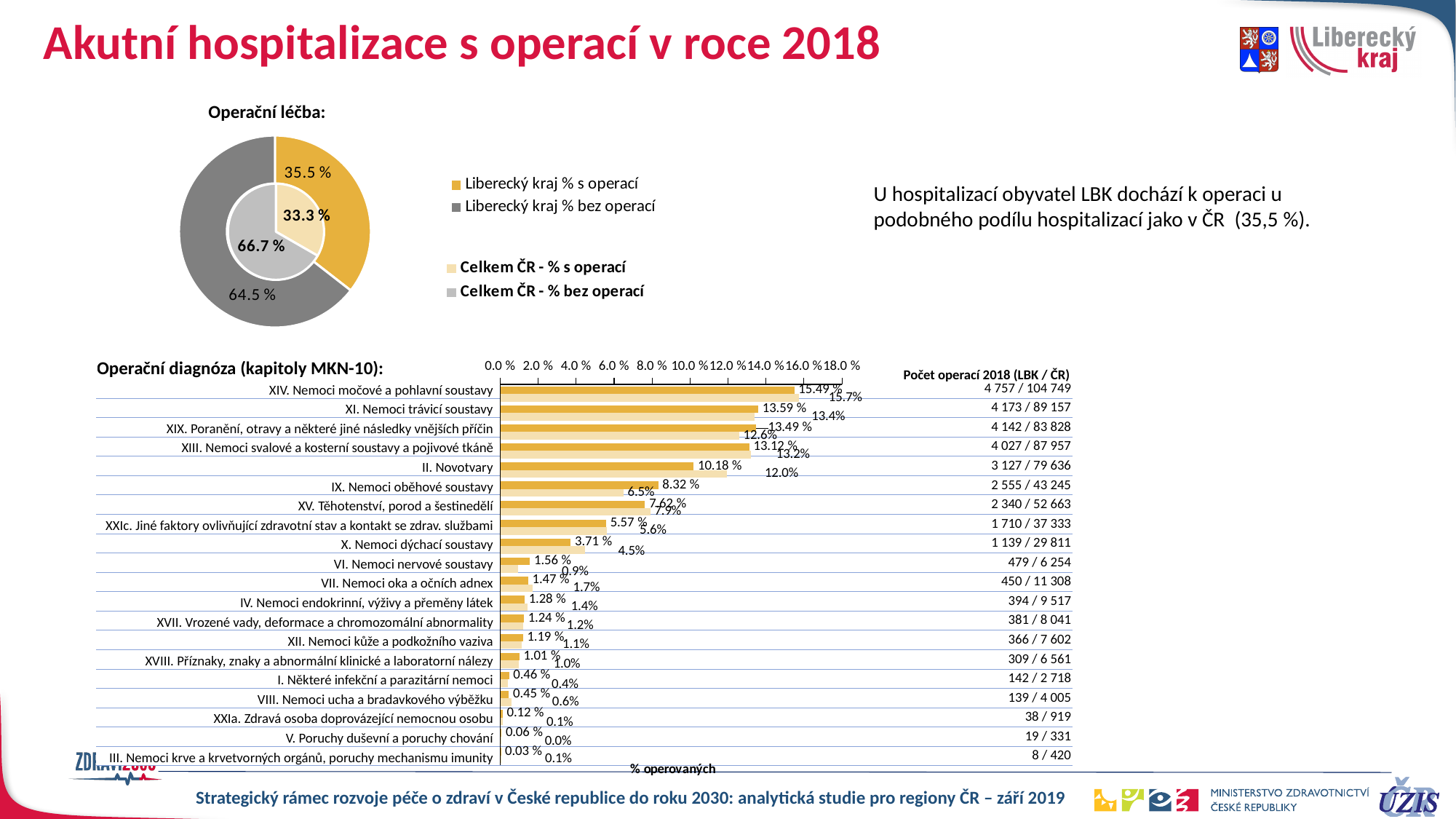
In the 'Operační diagnóza (kapitoly MKN-10)' bar chart, what is the Liberecký kraj value for 'II. Novotvary'? 10.18 % In the 'Operační léčba' doughnut chart, what percentage is shown for 'Liberecký kraj % s operací'? 35.5 % In the 'Operační diagnóza (kapitoly MKN-10)' bar chart, which diagnosis category has the highest Liberecký kraj value? XIV. Nemoci močové a pohlavní soustavy How many entries does the legend of the 'Operační léčba' doughnut chart list? 4 In the 'Operační diagnóza (kapitoly MKN-10)' bar chart, which is larger for 'IX. Nemoci oběhové soustavy': the Liberecký kraj value or the Celkem ČR value? Liberecký kraj (8.32 %) In the 'Operační diagnóza (kapitoly MKN-10)' bar chart, which diagnosis category has the lowest Liberecký kraj value? III. Nemoci krve a krvetvorných orgánů, poruchy mechanismu imunity In the 'Operační diagnóza (kapitoly MKN-10)' bar chart, what is the Celkem ČR value for 'X. Nemoci dýchací soustavy'? 4.5% In the 'Operační diagnóza (kapitoly MKN-10)' bar chart, how many diagnosis categories are listed? 20 In the 'Operační léčba' doughnut chart, what is the difference between 'Liberecký kraj % bez operací' and 'Liberecký kraj % s operací'? 29.0 % What type of chart is the 'Operační diagnóza (kapitoly MKN-10)' chart? bar chart In the 'Operační diagnóza (kapitoly MKN-10)' bar chart, what is the difference between the Liberecký kraj value and the Celkem ČR value for 'II. Novotvary'? 1.82 % In the 'Operační léčba' doughnut chart, what percentage is shown for 'Celkem ČR - % bez operací'? 66.7 %